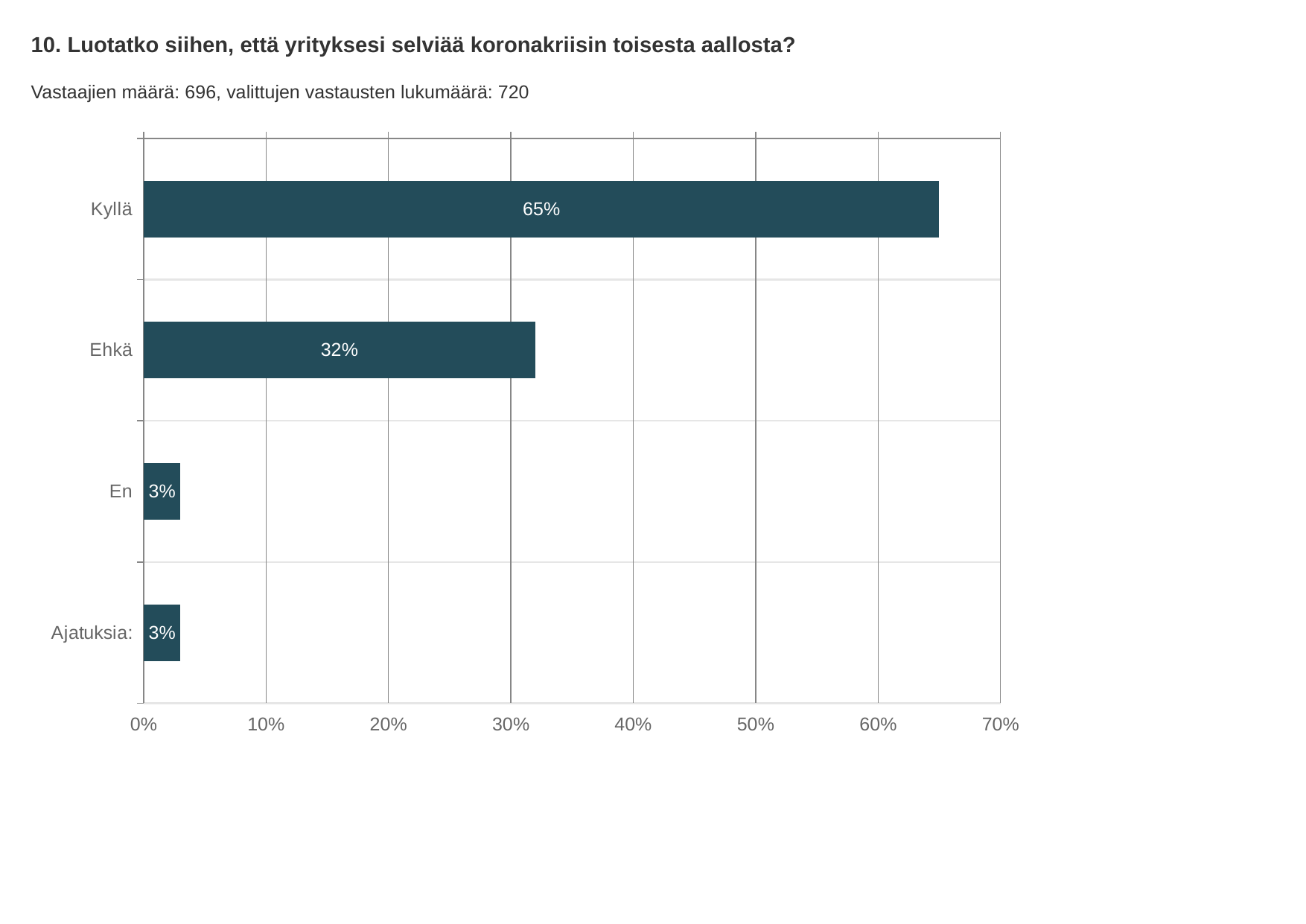
What is the value for Ehkä? 32% What is the number of respondents (Vastaajien määrä) stated on the slide? 696 What is the value for Kyllä? 65% What kind of chart is shown on the slide? bar chart What is the value for Ajatuksia:? 3% How many categories are shown in the chart? 4 What is the difference between the values for Ehkä and En? 29% Which is larger, the value for Kyllä or the value for Ehkä? Kyllä Is the value for Kyllä greater or less than 60%? greater What is the difference between the values for Kyllä and Ehkä? 33% What is the value for En? 3% Which category has the highest value? Kyllä